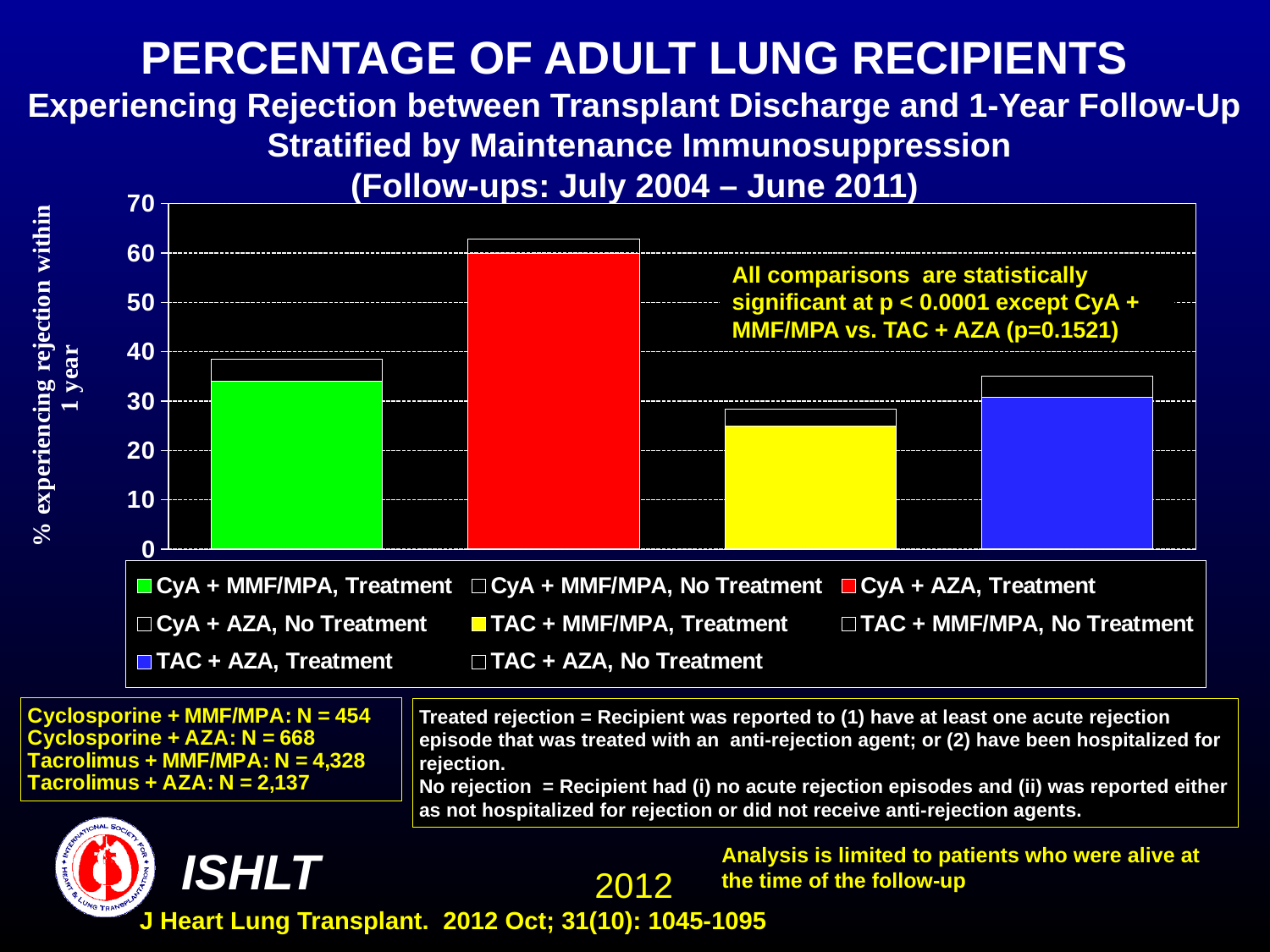
Which immunosuppression group has the highest percentage experiencing rejection within 1 year? CyA + AZA Is the value for TAC + MMF/MPA, Treatment greater or less than 30? less What kind of chart is shown on the slide? bar chart What is the label of the y axis? % experiencing rejection within 1 year How many series does the legend list? 8 Which is larger, the treated rejection percentage for CyA + AZA or for TAC + MMF/MPA? CyA + AZA Is the total height of the TAC + AZA bar greater or less than 30? greater What colour is the bar segment for TAC + MMF/MPA, Treatment? yellow Which immunosuppression group has the lowest percentage experiencing rejection within 1 year? TAC + MMF/MPA Is the value for CyA + AZA, Treatment greater or less than 50? greater How many stacked bars are plotted in the chart? 4